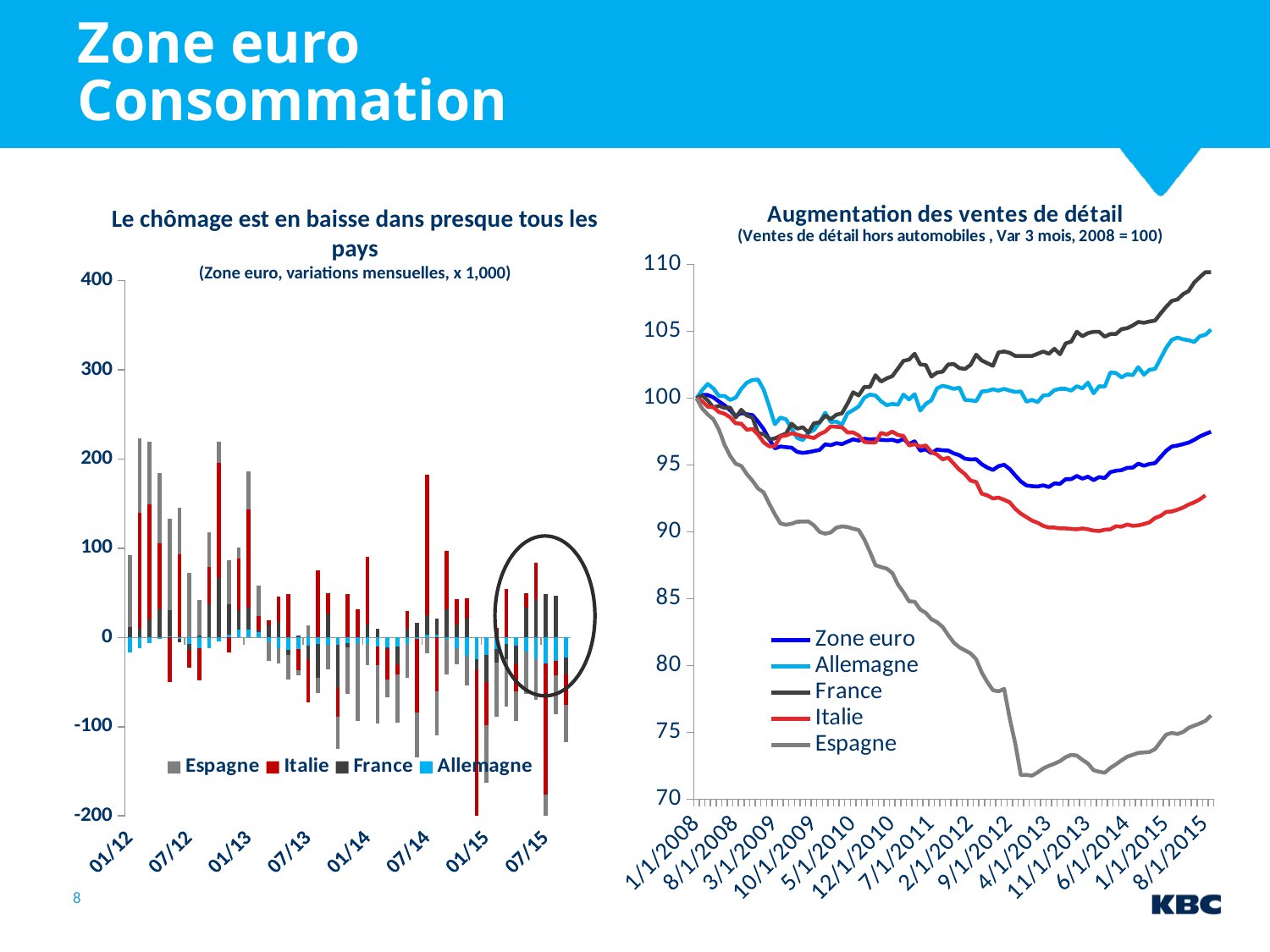
In the right chart 'Augmentation des ventes de détail', does the Espagne series rise or fall between 1/1/2008 and 4/1/2013? fall In the right chart 'Augmentation des ventes de détail', is the value for Espagne at 8/1/2015 greater or less than 80? less In the right chart 'Augmentation des ventes de détail', which series has the lowest value at the end of the period (8/1/2015)? Espagne In the right chart 'Augmentation des ventes de détail', is the value for Zone euro at 8/1/2015 greater or less than 100? less In the right chart 'Augmentation des ventes de détail', which is larger at 8/1/2015: Allemagne or Italie? Allemagne In the left chart 'Le chômage est en baisse dans presque tous les pays', which colour represents Allemagne in the legend? light blue In the left chart 'Le chômage est en baisse dans presque tous les pays', how many series does the legend list? 4 In the right chart 'Augmentation des ventes de détail', how many series does the legend list? 5 In the right chart 'Augmentation des ventes de détail', is the value for France at 8/1/2015 greater or less than 105? greater In the right chart 'Augmentation des ventes de détail', which series has the highest value at the end of the period (8/1/2015)? France What kind of chart is the left chart titled 'Le chômage est en baisse dans presque tous les pays'? bar chart What kind of chart is the right chart titled 'Augmentation des ventes de détail'? line chart